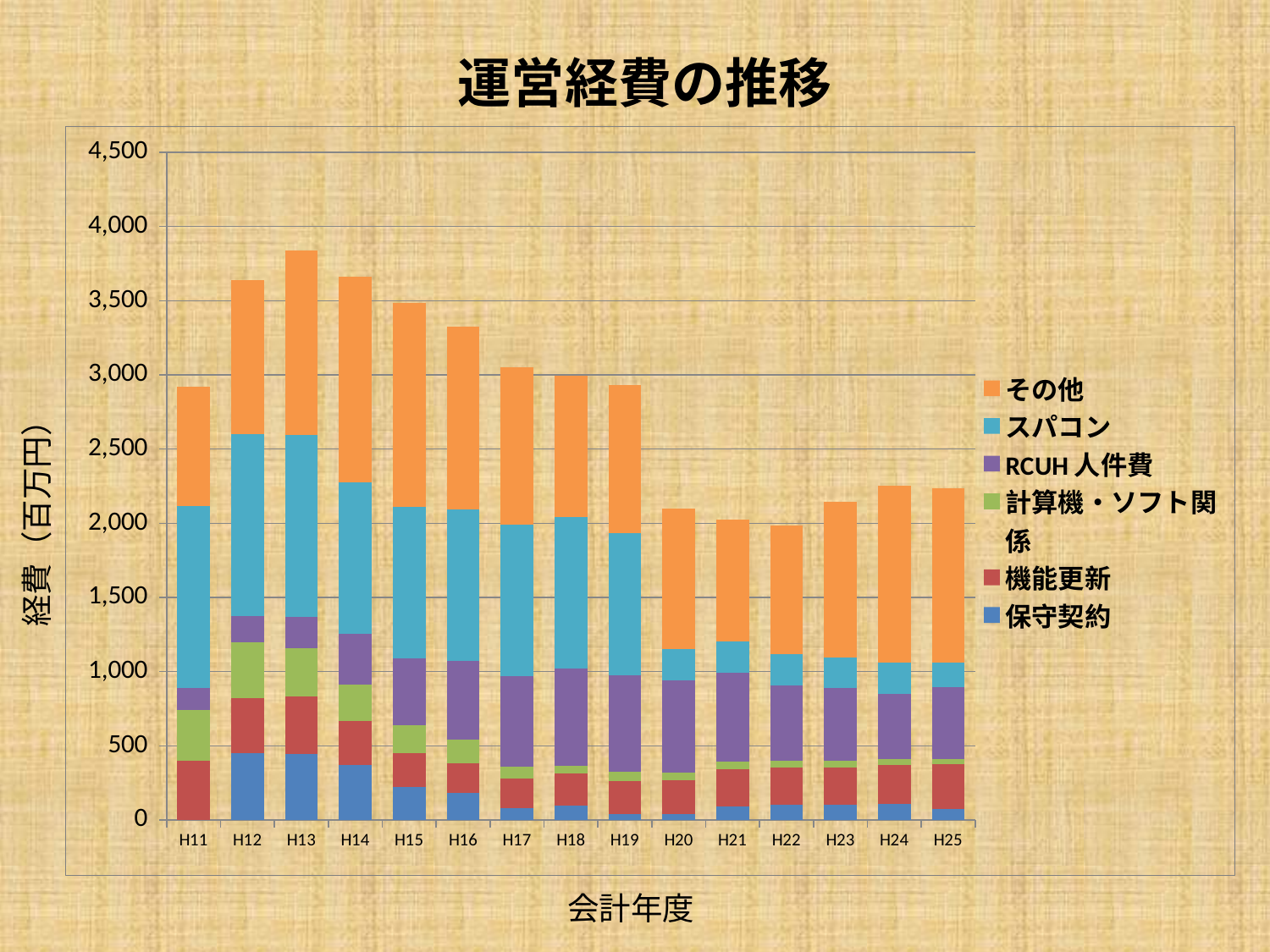
Is the total for H16 greater or less than 3,000? greater Is the total for H20 greater or less than 2,500? less How many series does the legend list? 6 Which has the larger total, H11 or H20? H11 Which has the larger total, H13 or H12? H13 How many fiscal years (categories) are shown on the x axis? 15 Do the total bar heights generally rise or fall from H13 to H22? fall Which fiscal year has the highest total operating cost? H13 What is the title of the chart? 運営経費の推移 Is the total for H24 greater or less than 2,000? greater What kind of chart is shown on the slide? Stacked bar chart